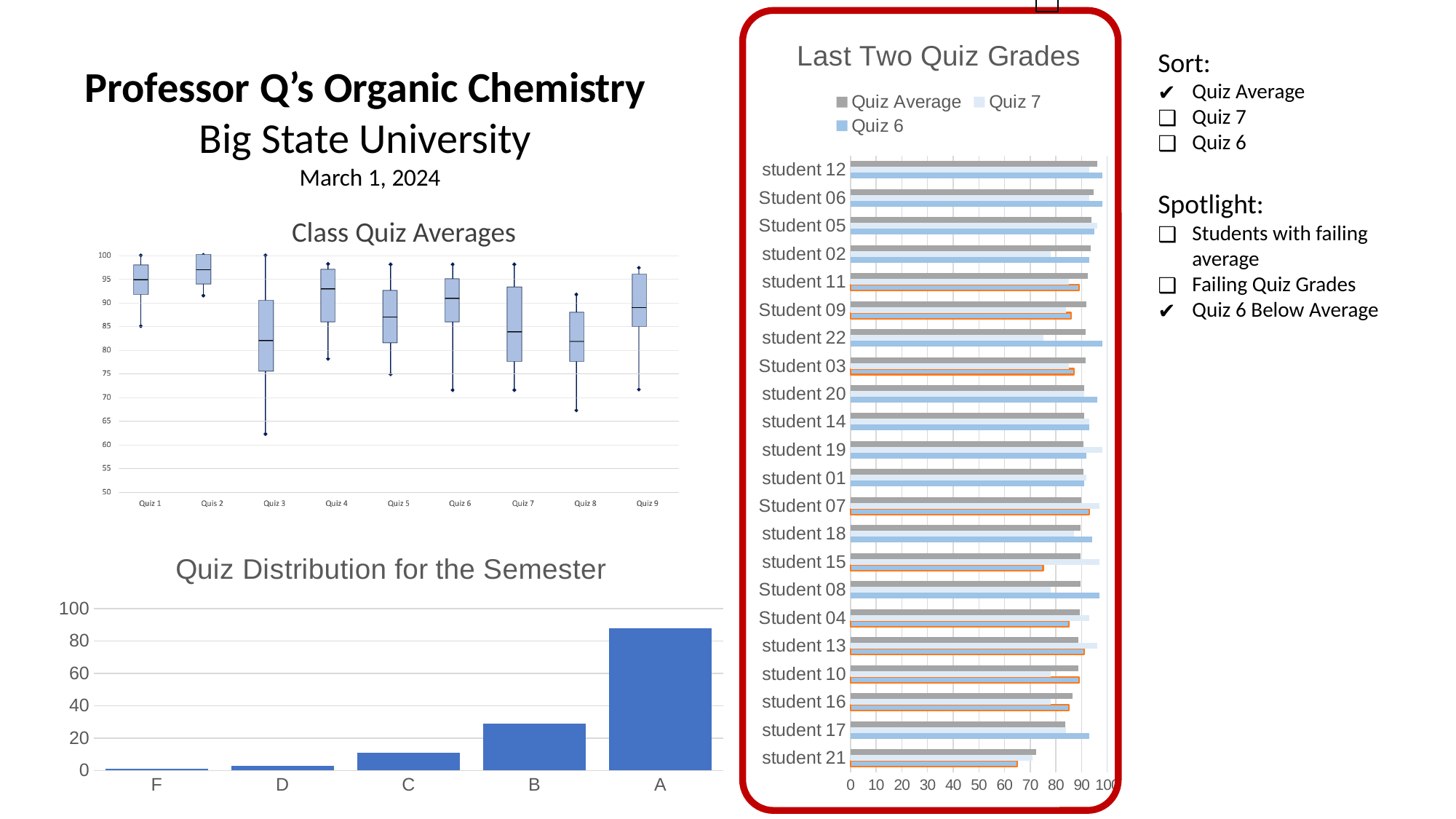
How many grade categories are shown in the "Quiz Distribution for the Semester" chart? 5 In the "Last Two Quiz Grades" chart, is the Quiz 6 value for student 21 greater or less than 70? less In the "Quiz Distribution for the Semester" chart, is the value for A greater or less than 80? greater In the "Quiz Distribution for the Semester" chart, which grade category has the lowest value? F In the "Quiz Distribution for the Semester" chart, do the values rise or fall moving from F to A along the x axis? rise In the "Quiz Distribution for the Semester" chart, which grade category has the highest value? A How many quizzes are shown on the x axis of the "Class Quiz Averages" chart? 9 What kind of chart is the "Quiz Distribution for the Semester" chart? bar chart How many students are shown in the "Last Two Quiz Grades" chart? 22 In the "Last Two Quiz Grades" chart, which student has the lowest Quiz Average? student 21 How many series does the legend of the "Last Two Quiz Grades" chart list? 3 In the "Quiz Distribution for the Semester" chart, is the value for B greater or less than 40? less